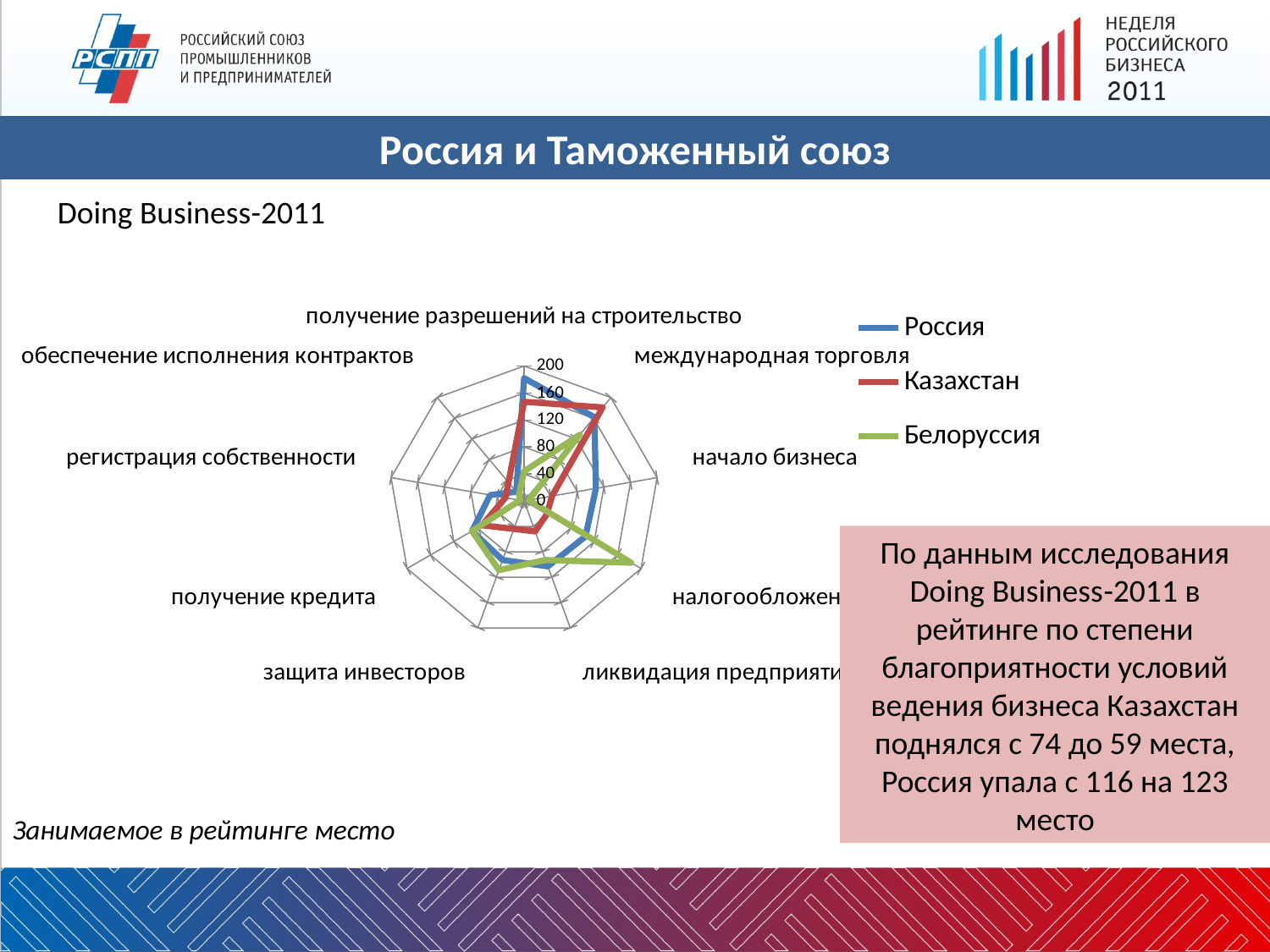
Is the value for Россия on начало бизнеса greater or less than 160? less Which series is drawn in blue in the chart? Россия What is the highest value shown on the chart's axis scale? 200 How many series does the chart legend list? 3 Is the value for Белоруссия on налогообложение greater or less than 120? greater On получение разрешений на строительство, which series has the larger value, Россия or Белоруссия? Россия Is the value for Россия on получение кредита greater or less than 120? less What kind of chart is shown on the slide? radar chart On налогообложение, which series has the larger value, Белоруссия or Россия? Белоруссия